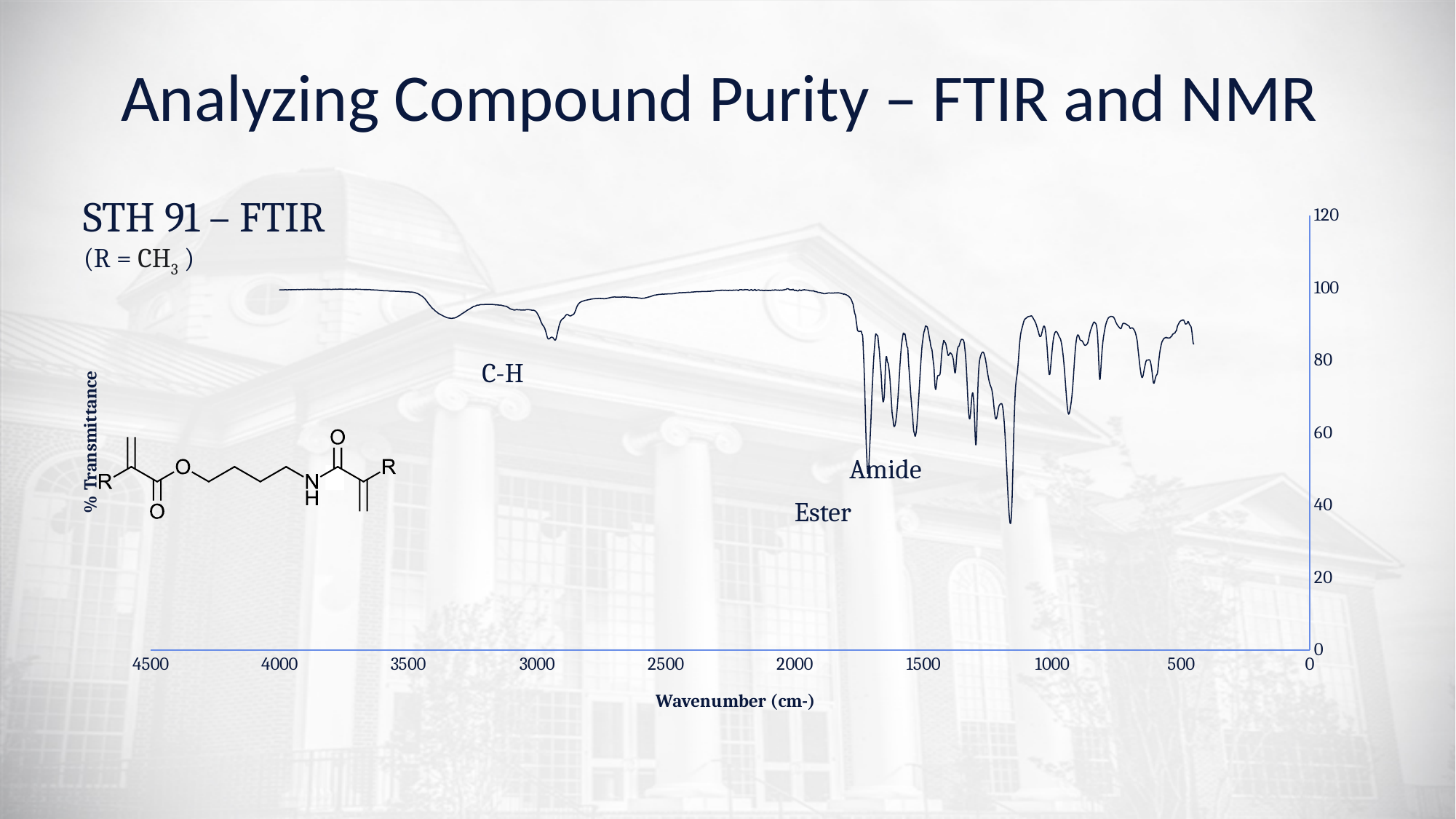
Is the lowest point of the spectrum (the deepest trough near 1150 cm-) greater or less than 40 % transmittance? less Is the transmittance at the right end of the trace, near 500 cm-, greater or less than 80? greater What is the label of the x axis of the chart? Wavenumber (cm-) Is the transmittance at the C-H dip near 2950 cm- greater or less than 80? greater Does the transmittance trace generally stay near 100 or drop well below it between 4000 and 2000 cm-? stays near 100 What is the title of the chart on the slide? STH 91 – FTIR What is the highest value shown on the y axis of the chart? 120 What kind of chart is shown on the slide? line chart